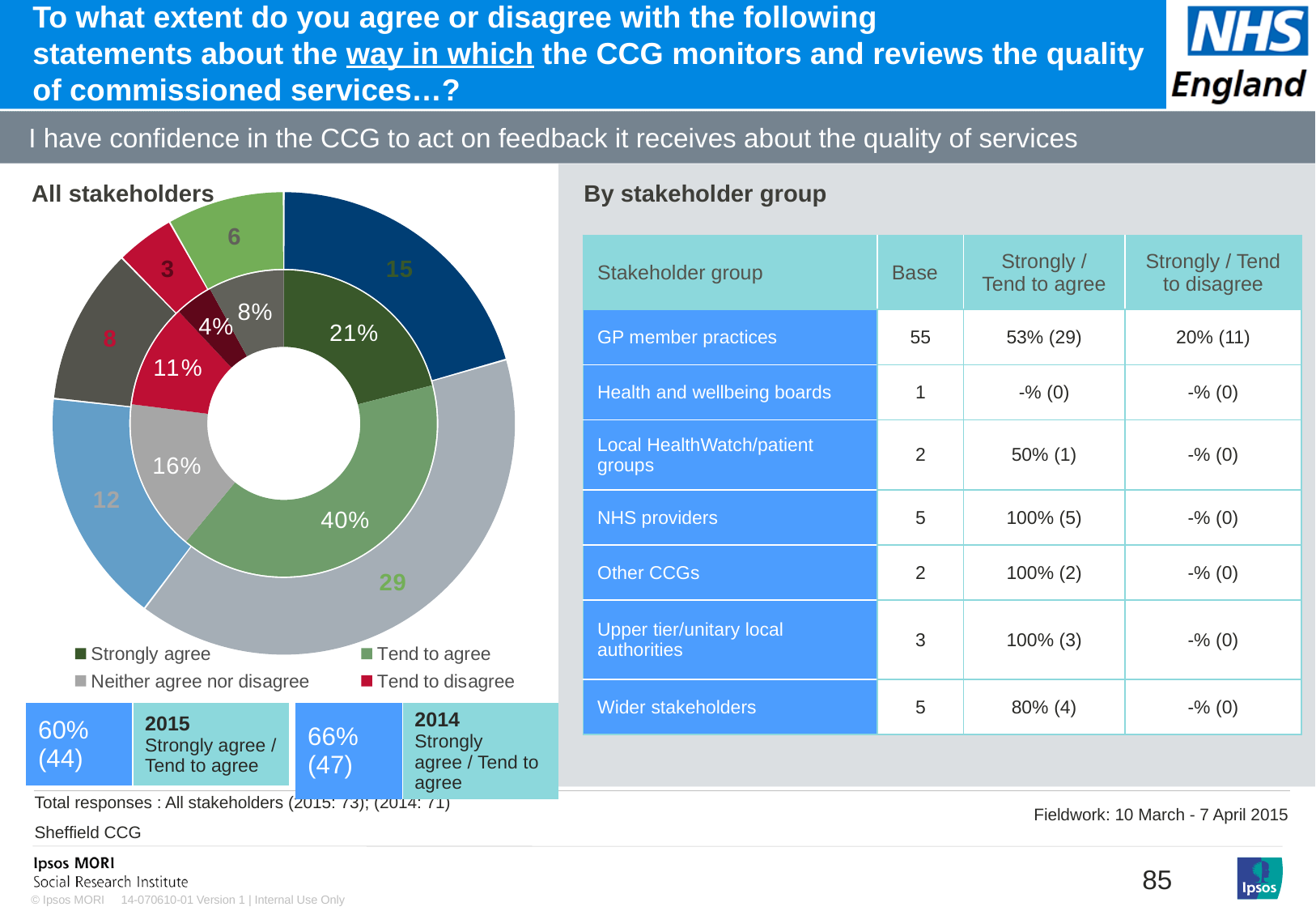
How many segments does the inner ring of the 'All stakeholders' chart have? 6 What is the title shown above the doughnut chart? All stakeholders In the 'All stakeholders' chart, which is larger: 'Strongly agree' or 'Neither agree nor disagree'? Strongly agree In the 'All stakeholders' chart, what percentage is shown for 'Strongly agree'? 21% How many entries does the legend of the 'All stakeholders' chart list? 4 In the 'All stakeholders' chart, what percentage is shown for 'Neither agree nor disagree'? 16% In the 'All stakeholders' chart, what percentage is shown for 'Tend to disagree'? 11% In the 'All stakeholders' chart, what is the difference in percentage points between 'Tend to agree' and 'Strongly agree'? 19 percentage points In the 'All stakeholders' chart, what percentage is shown for 'Tend to agree'? 40% What kind of chart is shown under 'All stakeholders'? doughnut chart In the 'All stakeholders' chart, which legend category has the largest share? Tend to agree In the 'All stakeholders' chart, which is larger: 'Tend to disagree' or 'Neither agree nor disagree'? Neither agree nor disagree